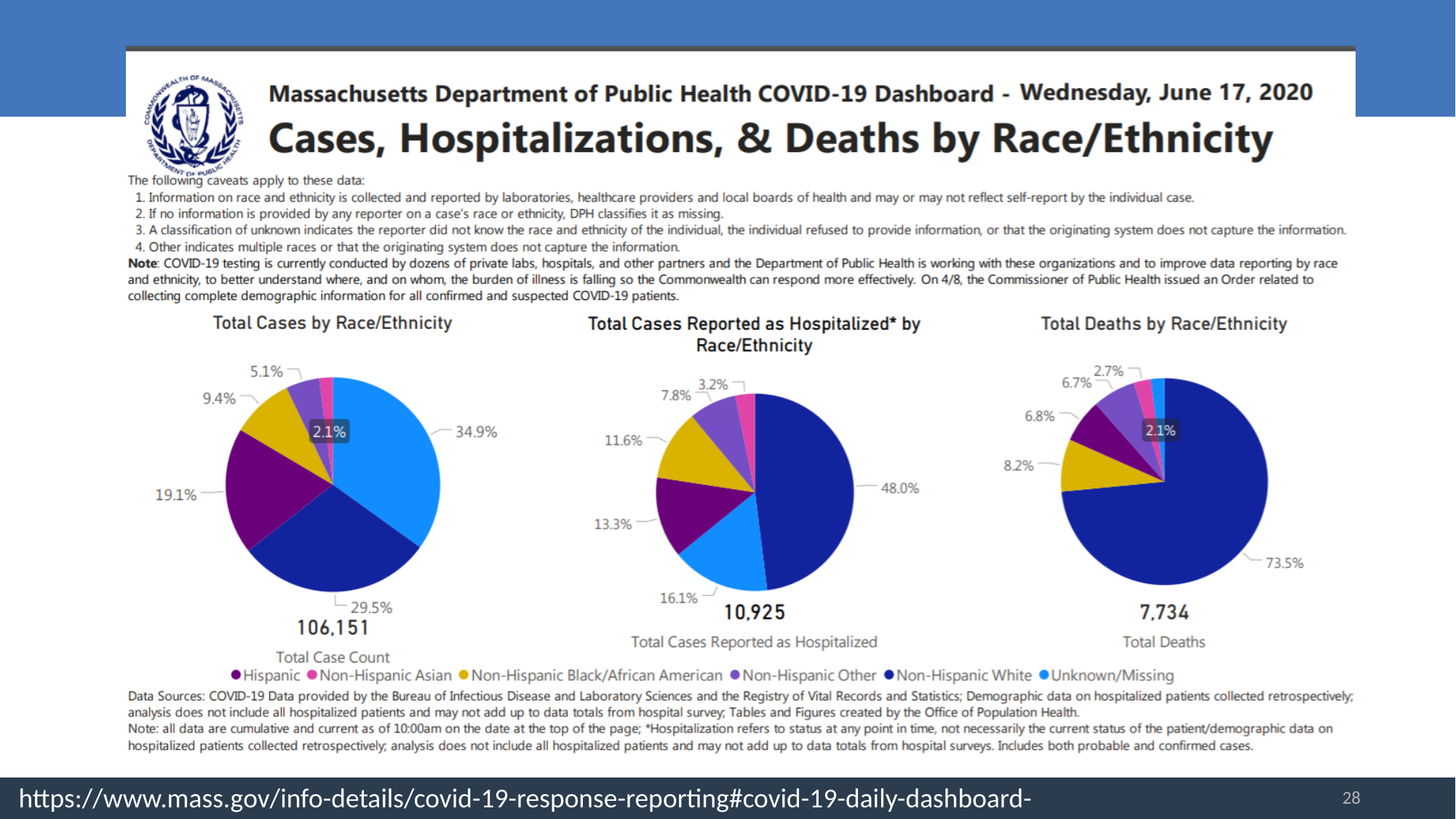
In the Total Cases by Race/Ethnicity chart, how much larger is the Unknown/Missing share than the Non-Hispanic White share? 5.4% In the Total Cases by Race/Ethnicity chart, what share of cases is Hispanic? 19.1% What is the Total Deaths figure shown under the Total Deaths by Race/Ethnicity chart? 7,734 How many categories does the shared legend list for the three charts? 6 What is the Total Case Count shown under the Total Cases by Race/Ethnicity chart? 106,151 In the Total Cases Reported as Hospitalized by Race/Ethnicity chart, what share is Non-Hispanic Black/African American? 11.6% What is the Total Cases Reported as Hospitalized figure shown under the middle chart? 10,925 In the Total Cases by Race/Ethnicity chart, what share of cases is Unknown/Missing? 34.9% In the Total Deaths by Race/Ethnicity chart, which category has the largest share? Non-Hispanic White What kind of chart is used for Total Cases by Race/Ethnicity? Pie chart